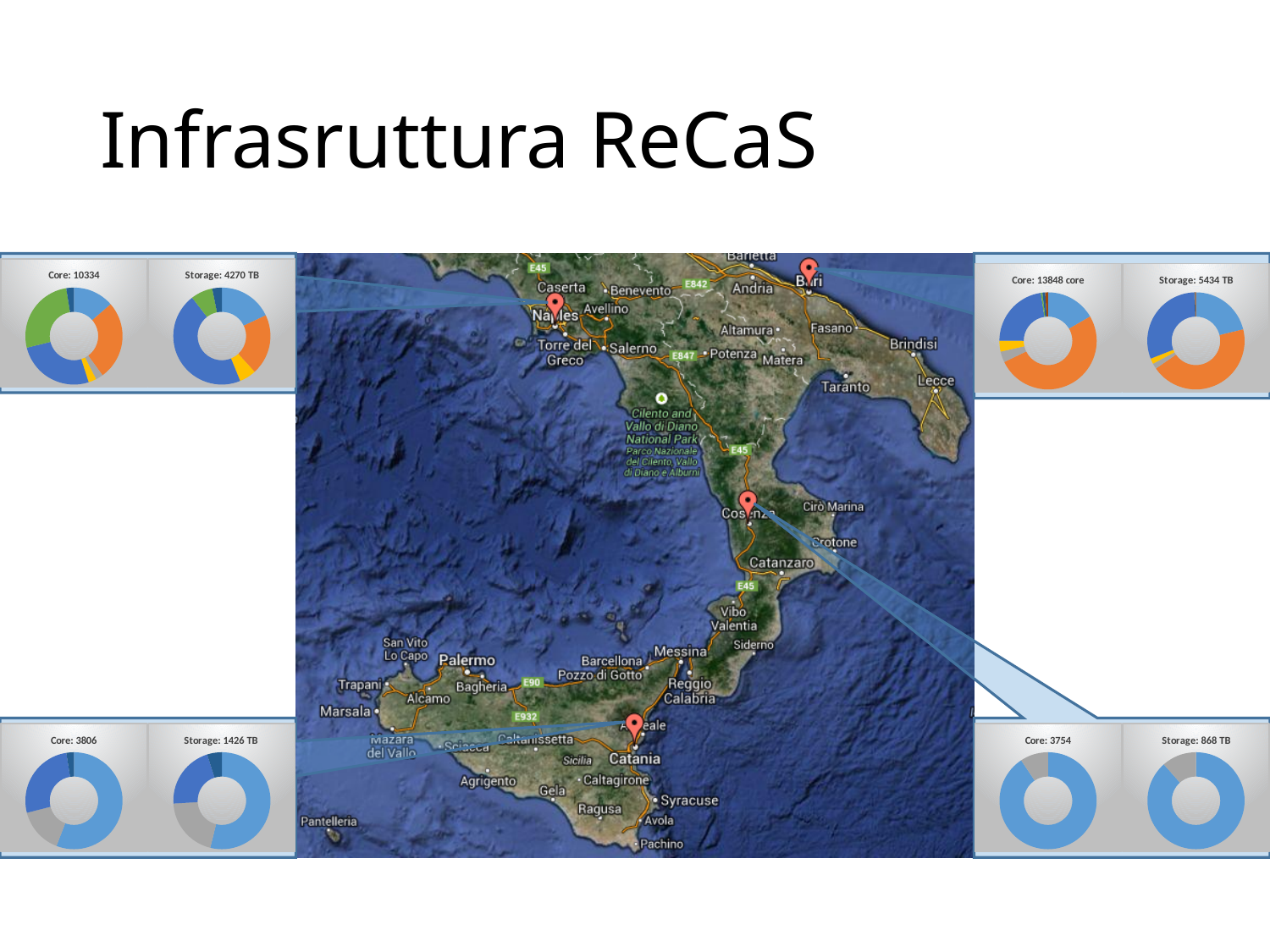
How many donut charts are shown on the slide in total? 8 Which of the four chart groups reports the lowest storage in its title? Bottom-right (Storage: 868 TB) What is the difference between the core count in the top-right title (13848) and the core count in the top-left title (10334)? 3514 Which reports more storage in its title: the top-left chart group or the top-right chart group? Top-right (Storage: 5434 TB) What kind of chart is the top-left chart titled "Core: 10334"? Donut (pie) chart What is the difference between the storage in the bottom-left title (1426 TB) and the storage in the bottom-right title (868 TB)? 558 TB What is the difference between the storage in the top-right title (5434 TB) and the storage in the top-left title (4270 TB)? 1164 TB What storage value is given in the title of the top-right storage chart? Storage: 5434 TB Which of the four chart groups reports the highest number of cores in its title? Top-right (Core: 13848 core) What core value is given in the title of the top-left core chart? Core: 10334 Which reports more cores in its title: the bottom-left chart group (Core: 3806) or the bottom-right chart group (Core: 3754)? Bottom-left (Core: 3806)